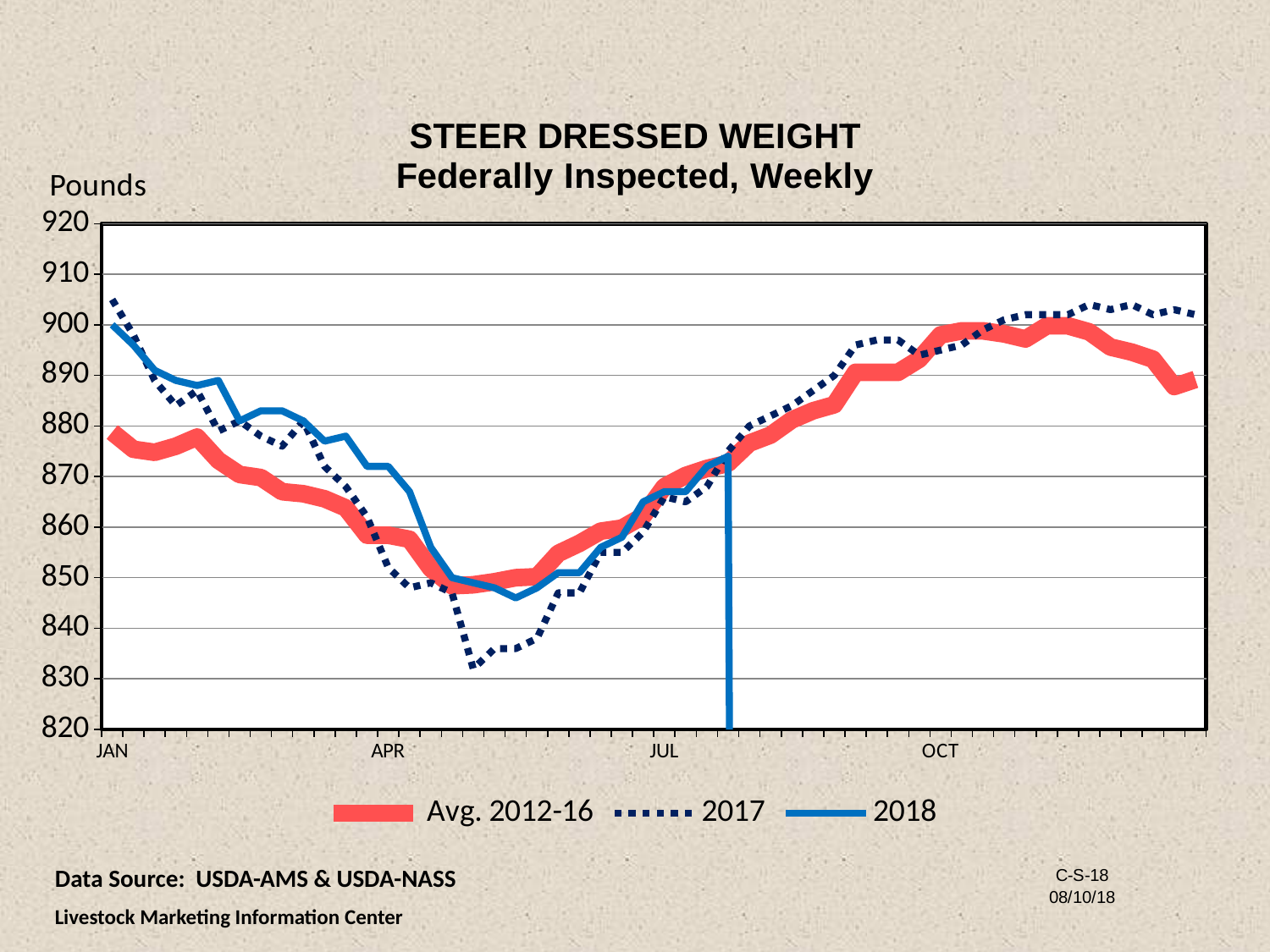
How many series does the legend list? 3 Which series reaches the lowest point on the chart? 2017 What is the title of the chart? STEER DRESSED WEIGHT Federally Inspected, Weekly Does the Avg. 2012-16 line rise or fall from January to April? fall What kind of chart is shown on the slide? line chart Is the value for Avg. 2012-16 at the start of January greater or less than 890? less What unit is shown on the y-axis label? Pounds Is the lowest value of the 2017 line greater or less than 840? less Around April, which is higher: the 2018 line or the Avg. 2012-16 line? 2018 At the start of January, which is higher: the 2017 line or the Avg. 2012-16 line? 2017 Is the value for 2017 at the start of January greater or less than 900? greater